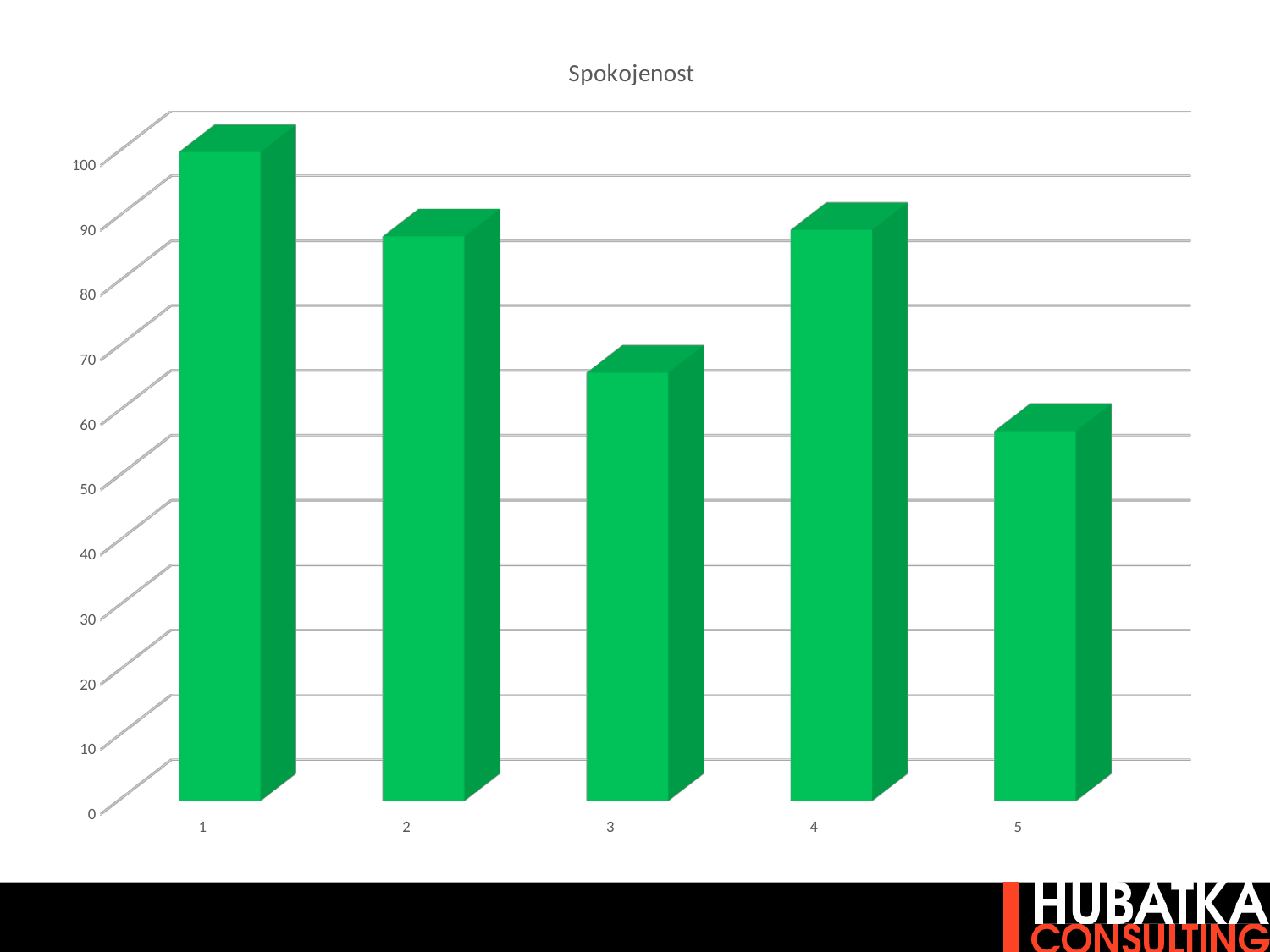
Is the value for category 4 greater or less than 80? greater Is the value for category 1 greater or less than 90? greater Which has the larger value, category 1 or category 3? 1 How many categories are shown on the x axis of the chart? 5 What kind of chart is shown on the slide? bar chart Which category has the lowest value in the chart? 5 Is the value for category 2 greater or less than 80? greater What is the title of the chart? Spokojenost Which has the larger value, category 3 or category 5? 3 Which category has the highest value in the chart? 1